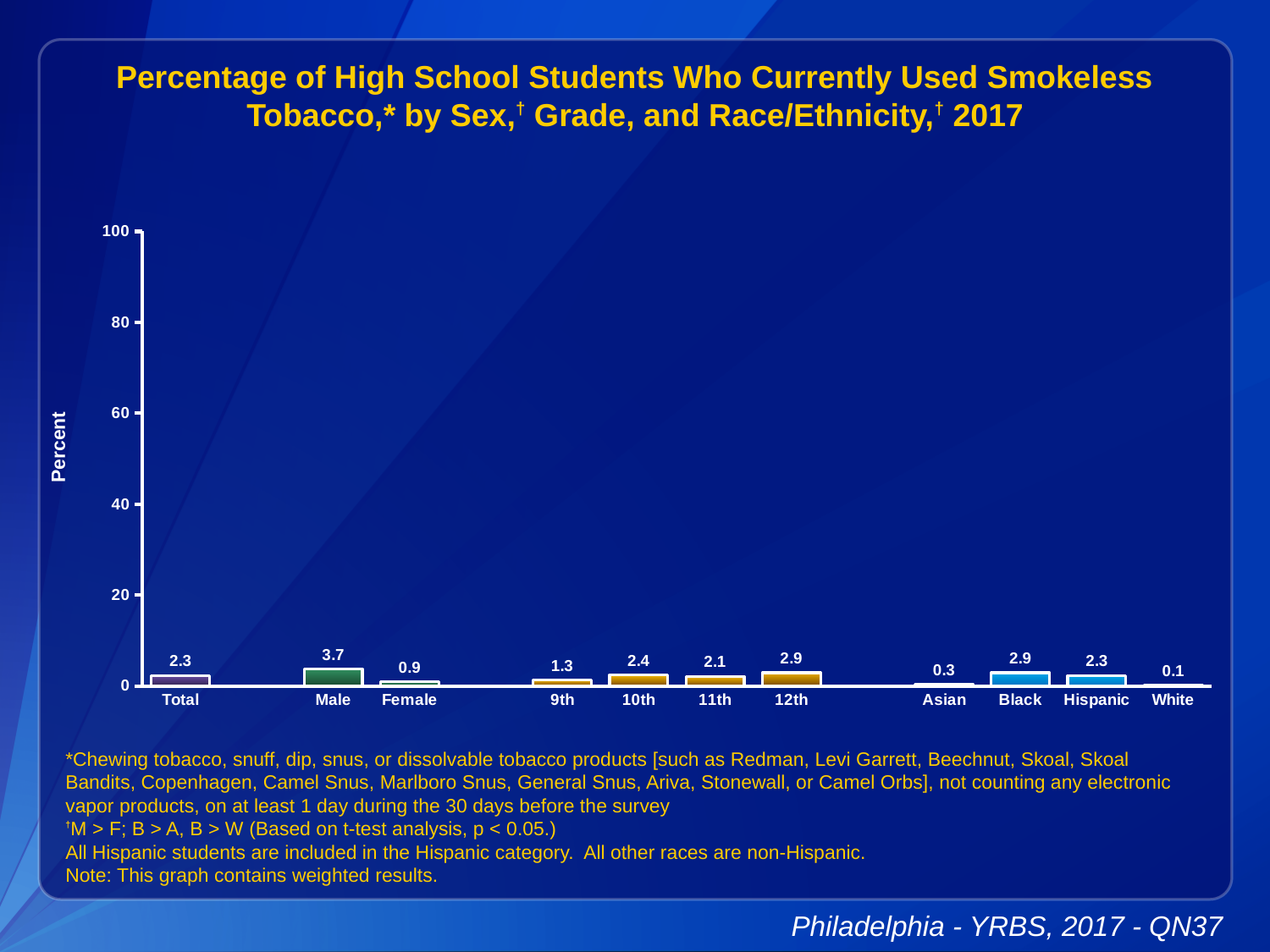
What is the value for Male? 3.7 Which category has the lowest value? White How many categories are shown on the x axis? 11 Which is larger, the value for 10th or the value for 11th? 10th What kind of chart is this? bar chart What is the difference between the values for Male and Female? 2.8 What is the label of the y axis? Percent Is the value for 12th greater or less than 20? less Do the values rise or fall from 9th to 10th grade? rise Which category has the highest value? Male What is the value for Total? 2.3 What is the value for Asian? 0.3